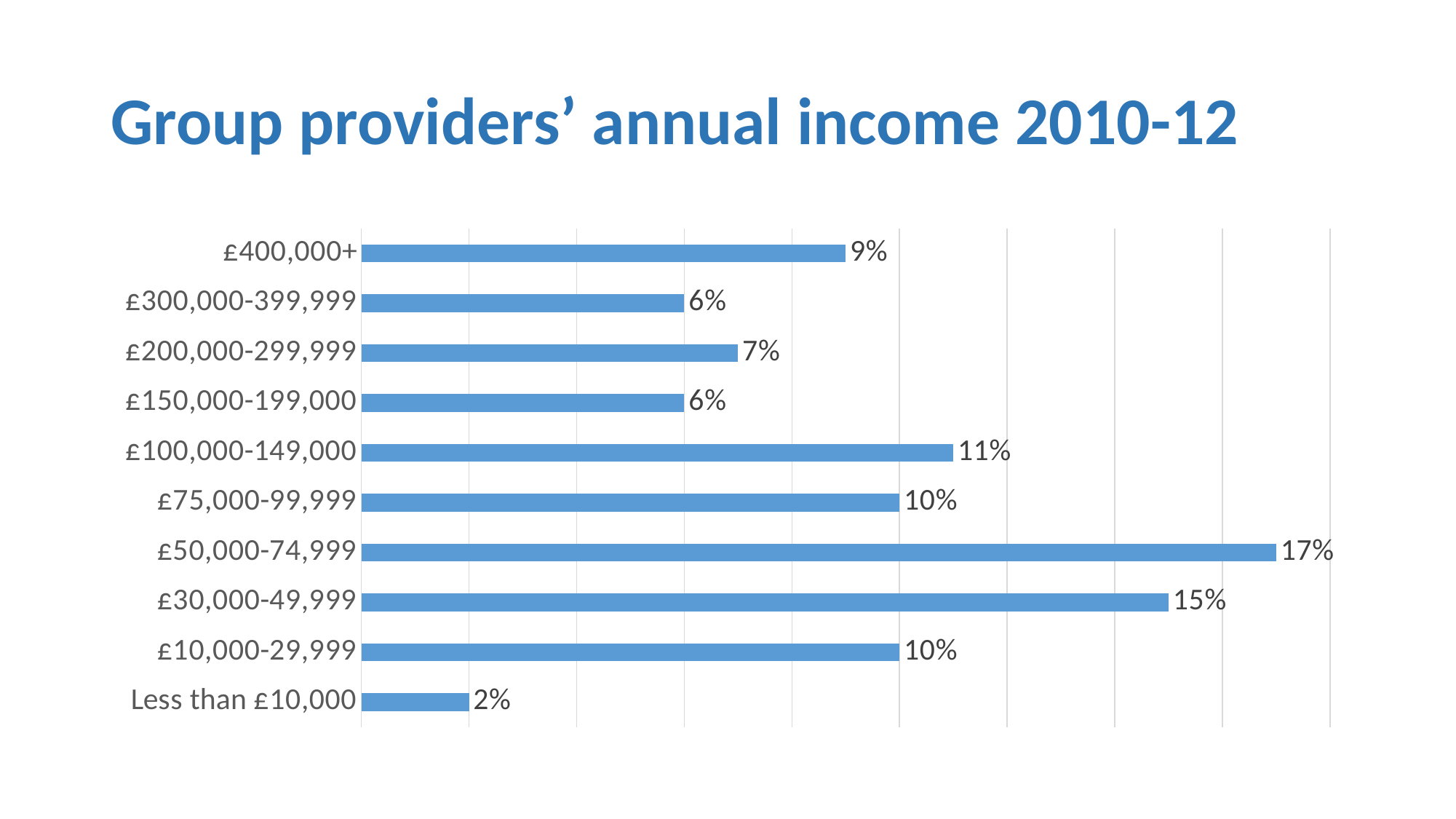
What percentage of group providers had an annual income of £50,000-74,999? 17% What is the difference in percentage points between the £50,000-74,999 band and the £30,000-49,999 band? 2 How many income bands are shown on the chart? 10 Which two income bands both show a value of 10%? £75,000-99,999 and £10,000-29,999 What type of chart is shown on the slide? Bar chart What percentage is shown for the 'Less than £10,000' category? 2% What is the value shown for the £100,000-149,000 income band? 11% What is the title of the chart? Group providers' annual income 2010-12 What is the combined percentage for the £300,000-399,999 and £150,000-199,000 bands? 12% Which income band has the highest percentage? £50,000-74,999 Which is larger: the value for £400,000+ or the value for £200,000-299,999? £400,000+ Which income band has the lowest percentage? Less than £10,000